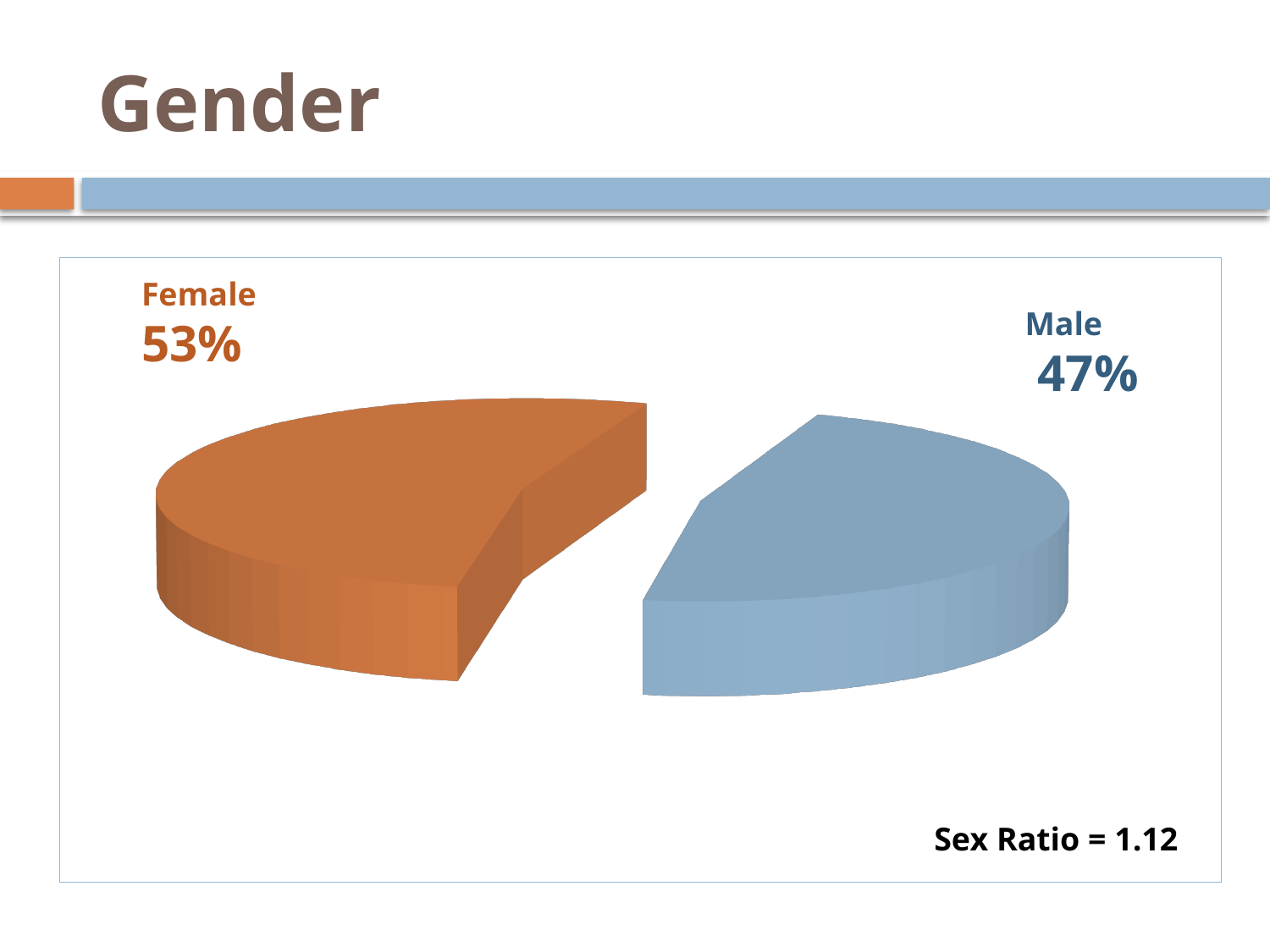
What kind of chart is shown on the slide? Pie chart What percentage of the pie chart is Male? 47% What is the sex ratio stated on the chart? 1.12 Which category has the smallest share of the pie chart? Male What percentage of the pie chart is Female? 53% What colour is the Male slice of the pie chart? Blue What is the difference in percentage points between the Female and Male shares? 6 How many slices does the pie chart have? 2 What is the title of the slide containing the chart? Gender Which category has the largest share of the pie chart? Female Which share is larger, Female or Male? Female